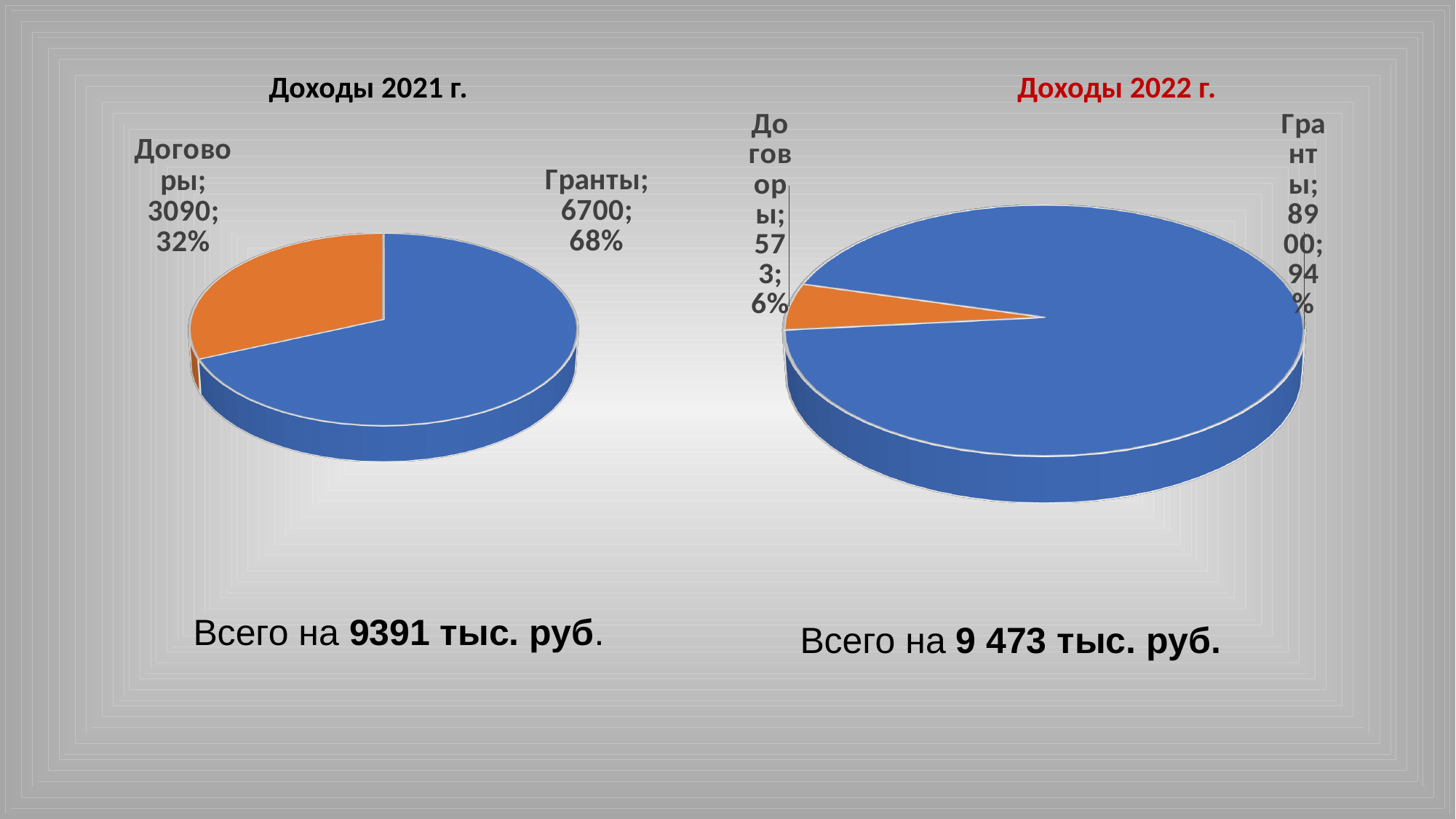
In the chart titled "Доходы 2022 г.", how many categories are shown? 2 In the chart titled "Доходы 2021 г.", which category is the largest? Гранты In the chart titled "Доходы 2021 г.", what is the difference between the values for Гранты and Договоры? 3610 In the chart titled "Доходы 2022 г.", what is the value for Договоры? 573 In the chart titled "Доходы 2021 г.", what is the value for Гранты? 6700 In the chart titled "Доходы 2022 г.", what share of the pie does Гранты take? 94% In the chart titled "Доходы 2021 г.", what share of the pie does Договоры take? 32% In the chart titled "Доходы 2022 г.", what is the value for Гранты? 8900 In the chart titled "Доходы 2021 г.", what is the value for Договоры? 3090 In the chart titled "Доходы 2022 г.", which category is the smallest? Договоры What kind of chart is the chart titled "Доходы 2022 г."? Pie chart In the chart titled "Доходы 2021 г.", what colour is the Договоры slice? Orange